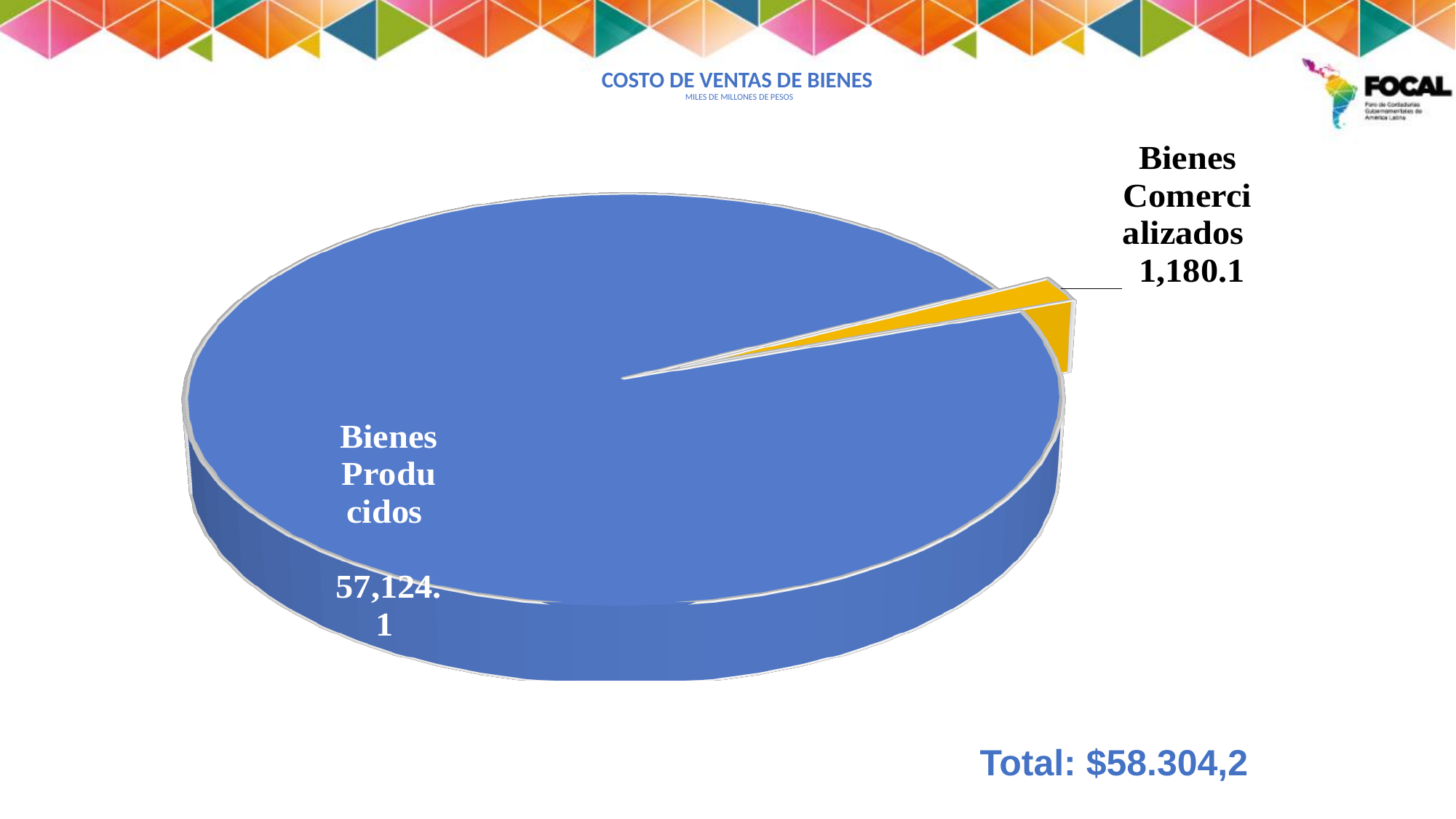
Which category has the smallest slice of the pie? Bienes Comercializados What is the difference between the values for Bienes Producidos and Bienes Comercializados? 55,944.0 What type of chart is shown on the slide? Pie chart How many slices does the pie chart have? 2 What is the value for Bienes Producidos? 57,124.1 What is the title of the chart? COSTO DE VENTAS DE BIENES What is the value for Bienes Comercializados? 1,180.1 Which is larger, Bienes Producidos or Bienes Comercializados? Bienes Producidos Which category has the largest slice of the pie? Bienes Producidos What colour is the Bienes Comercializados slice? Yellow What total is printed on the slide? $58.304,2